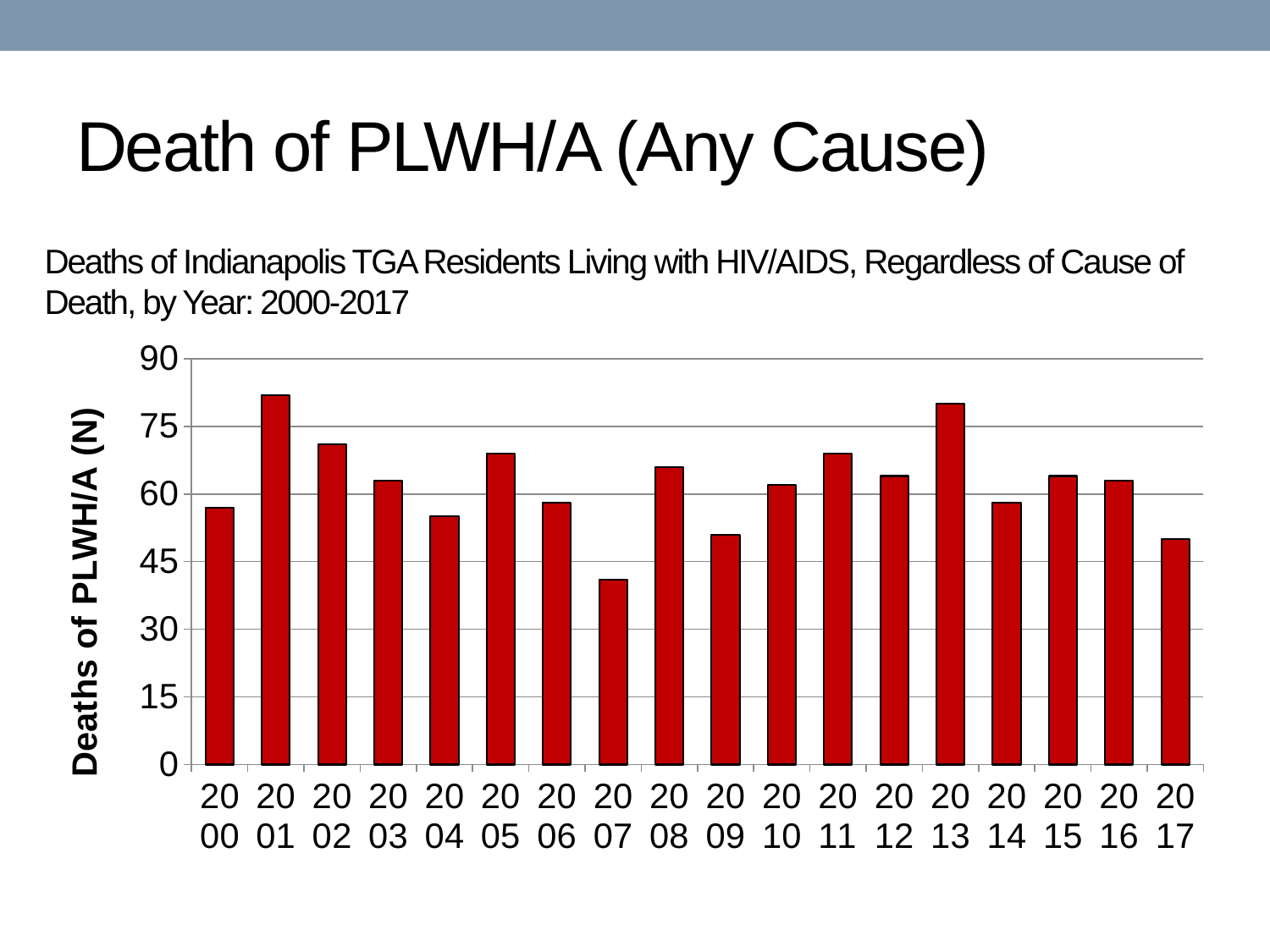
Is the value for 2009 greater or less than 45? greater Is the value for 2001 greater or less than 75? greater What kind of chart is shown on the slide? bar chart Which year has the highest number of deaths in the chart? 2001 Is the value for 2002 greater or less than 75? less Which year has more deaths, 2013 or 2017? 2013 Which year has more deaths, 2004 or 2002? 2002 How many years (bars) are plotted in the chart? 18 What is the label on the vertical axis of the chart? Deaths of PLWH/A (N) Which year has the lowest number of deaths in the chart? 2007